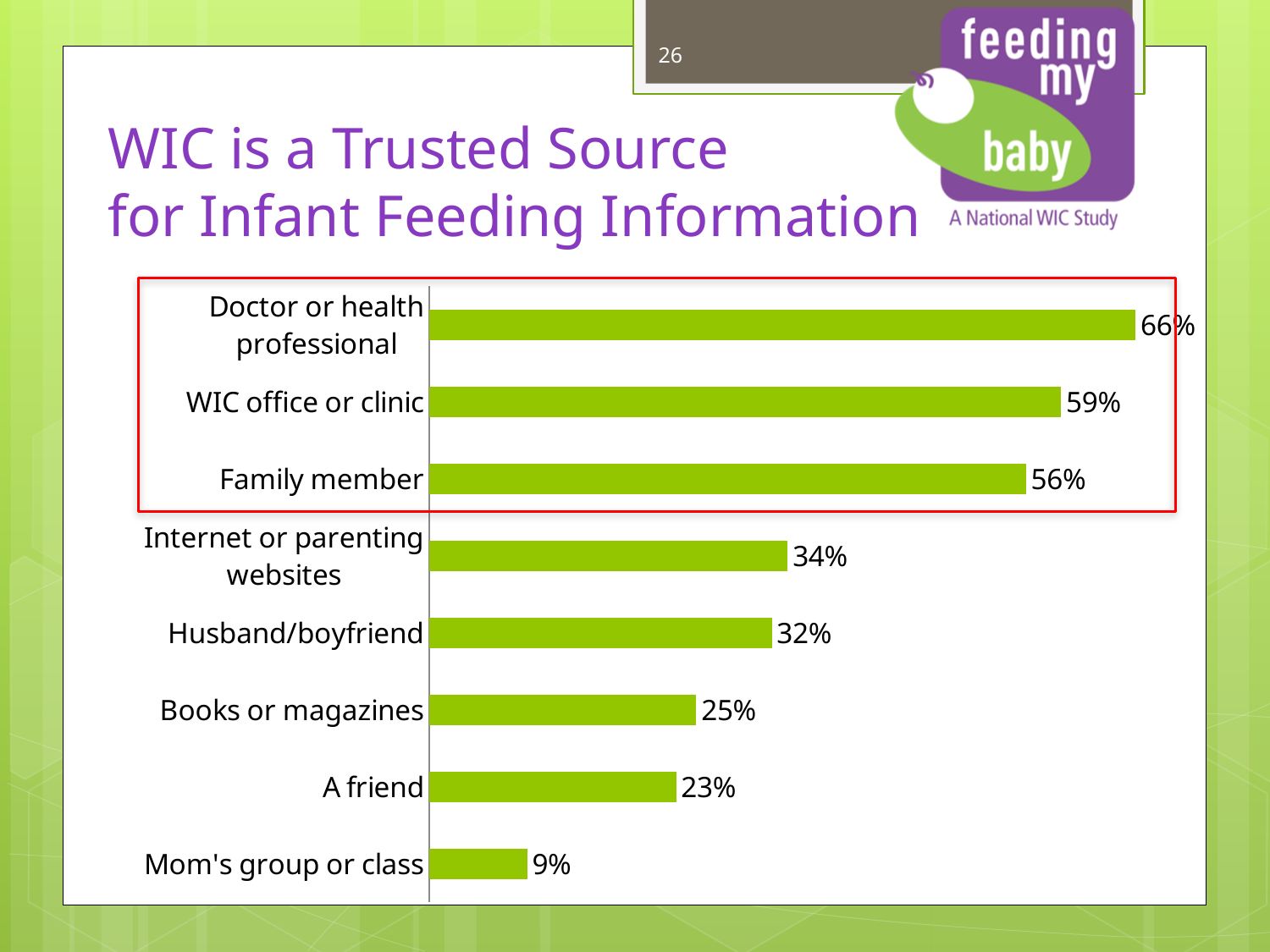
How many categories are shown in the chart? 8 Which is larger, the value for Husband/boyfriend or the value for Books or magazines? Husband/boyfriend What is the difference between the values for Doctor or health professional and WIC office or clinic? 7% How many categories are enclosed in the red box on the chart? 3 What colour are the bars in the chart? Green Which category has the highest value? Doctor or health professional What is the value for Mom's group or class? 9% What is the value for WIC office or clinic? 59% What is the difference between the values for Family member and A friend? 33% What kind of chart is shown on the slide? Bar chart Which category has the lowest value? Mom's group or class What is the value for Internet or parenting websites? 34%